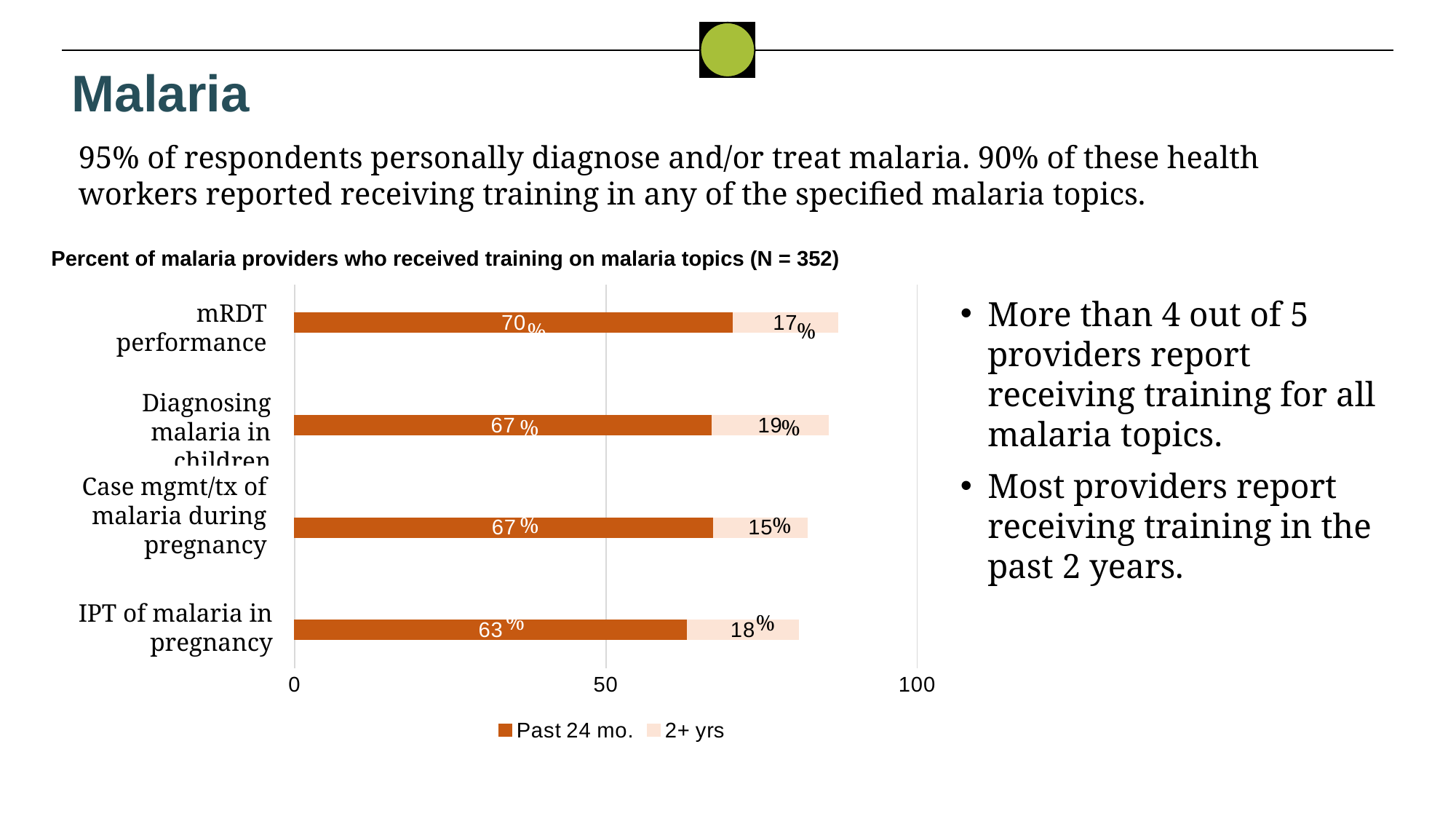
What percent of malaria providers received training on mRDT performance in the past 24 months? 70% What is the total percentage of providers who received any training on mRDT performance (both series combined)? 87% What is the 'Past 24 mo.' value for Case mgmt/tx of malaria during pregnancy? 67% Which is larger: the '2+ yrs' value for Diagnosing malaria in children or for mRDT performance? Diagnosing malaria in children Which malaria topic has the highest 'Past 24 mo.' training percentage? mRDT performance Which malaria topic has the lowest '2+ yrs' training percentage? Case mgmt/tx of malaria during pregnancy How many series does the legend list? 2 What type of chart is used to show the percent of malaria providers who received training? Stacked bar chart What percent of malaria providers received training on IPT of malaria in pregnancy 2+ years ago? 18% Which malaria topic has the lowest 'Past 24 mo.' training percentage? IPT of malaria in pregnancy What is the difference between the 'Past 24 mo.' values for mRDT performance and IPT of malaria in pregnancy? 7 percentage points How many malaria topics are shown in the chart? 4